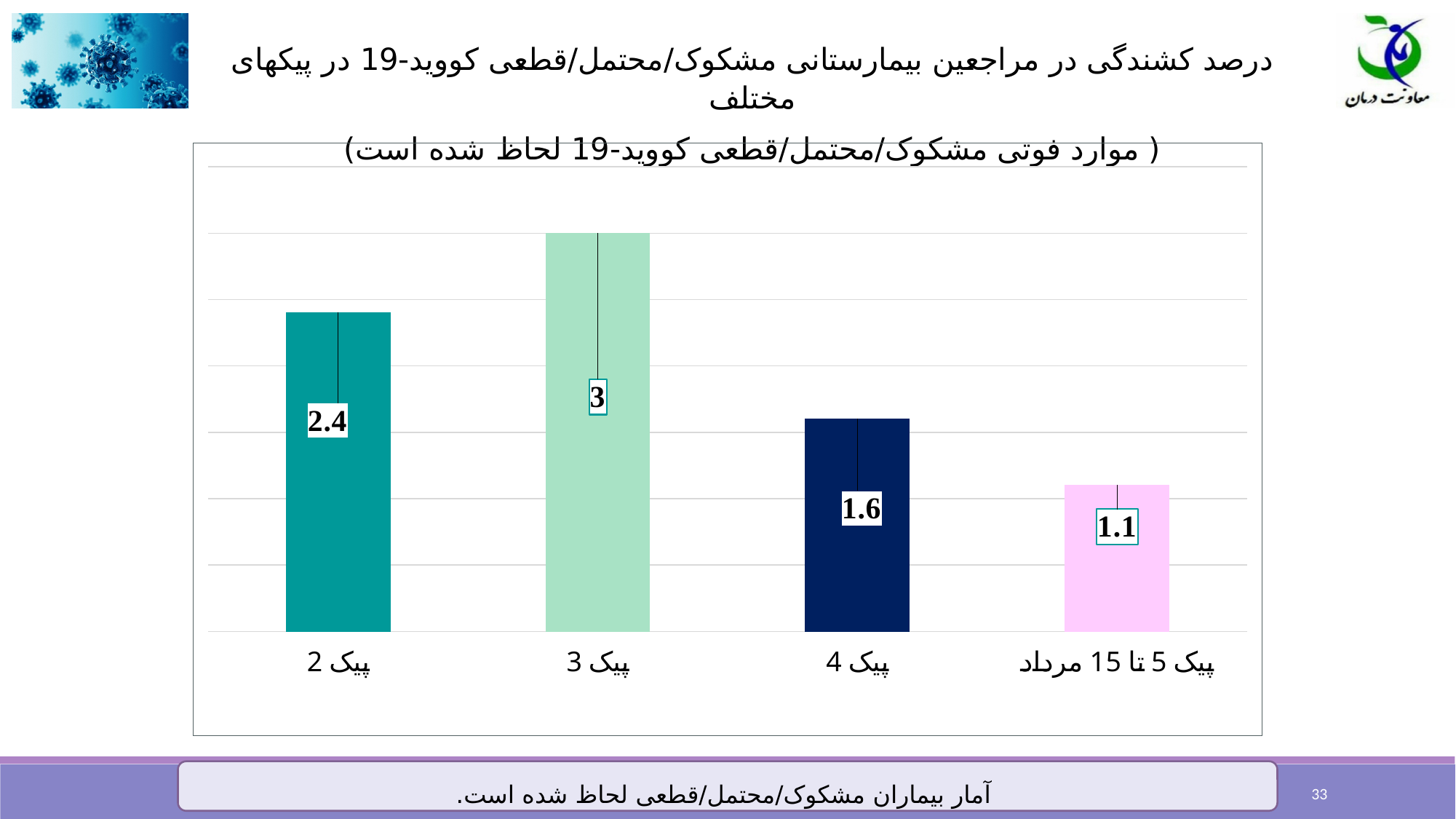
What is the difference between the values for پیک 3 and پیک 2? 0.6 What is the value shown for پیک 5 تا 15 مرداد? 1.1 What is the difference between the values for پیک 4 and پیک 5 تا 15 مرداد? 0.5 Which category has the highest value? پیک 3 How many categories are shown on the x axis? 4 What is the value shown for پیک 3? 3 Which is larger, the value for پیک 2 or the value for پیک 4? پیک 2 Which category has the lowest value? پیک 5 تا 15 مرداد Do the values rise or fall from پیک 3 to پیک 5 تا 15 مرداد along the x axis? fall What is the value shown for پیک 4? 1.6 What is the value shown for پیک 2? 2.4 What kind of chart is shown on the slide? bar chart